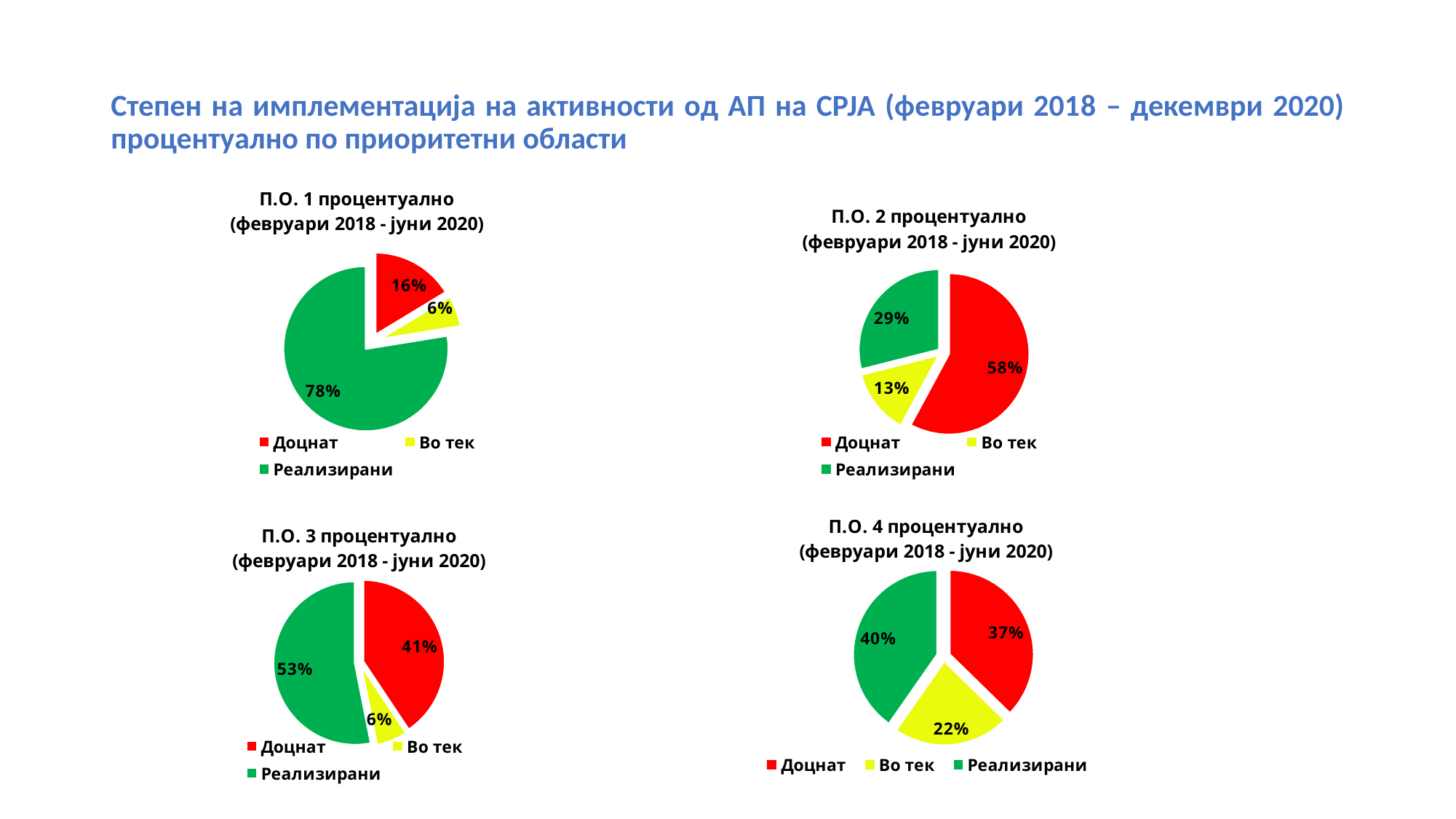
In the 'П.О. 4 процентуално' chart, which is larger, Доцнат or Реализирани? Реализирани How many pie charts are shown on the slide? 4 In the 'П.О. 3 процентуално' chart, what share is labelled for Во тек? 6% In the 'П.О. 3 процентуално' chart, what is the difference between the Реализирани and Доцнат shares? 12% In the 'П.О. 4 процентуално' chart, what share is labelled for Во тек? 22% What kind of chart is the 'П.О. 1 процентуално' chart? Pie chart In the 'П.О. 1 процентуално' chart, what share is labelled for Реализирани? 78% In the 'П.О. 2 процентуално' chart, what share is labelled for Доцнат? 58% In the 'П.О. 2 процентуално' chart, which category has the smallest slice? Во тек How many categories does the legend of the 'П.О. 4 процентуално' chart list? 3 In the 'П.О. 3 процентуално' chart, which category has the largest slice? Реализирани In the 'П.О. 1 процентуално' chart, what share is labelled for Доцнат? 16%